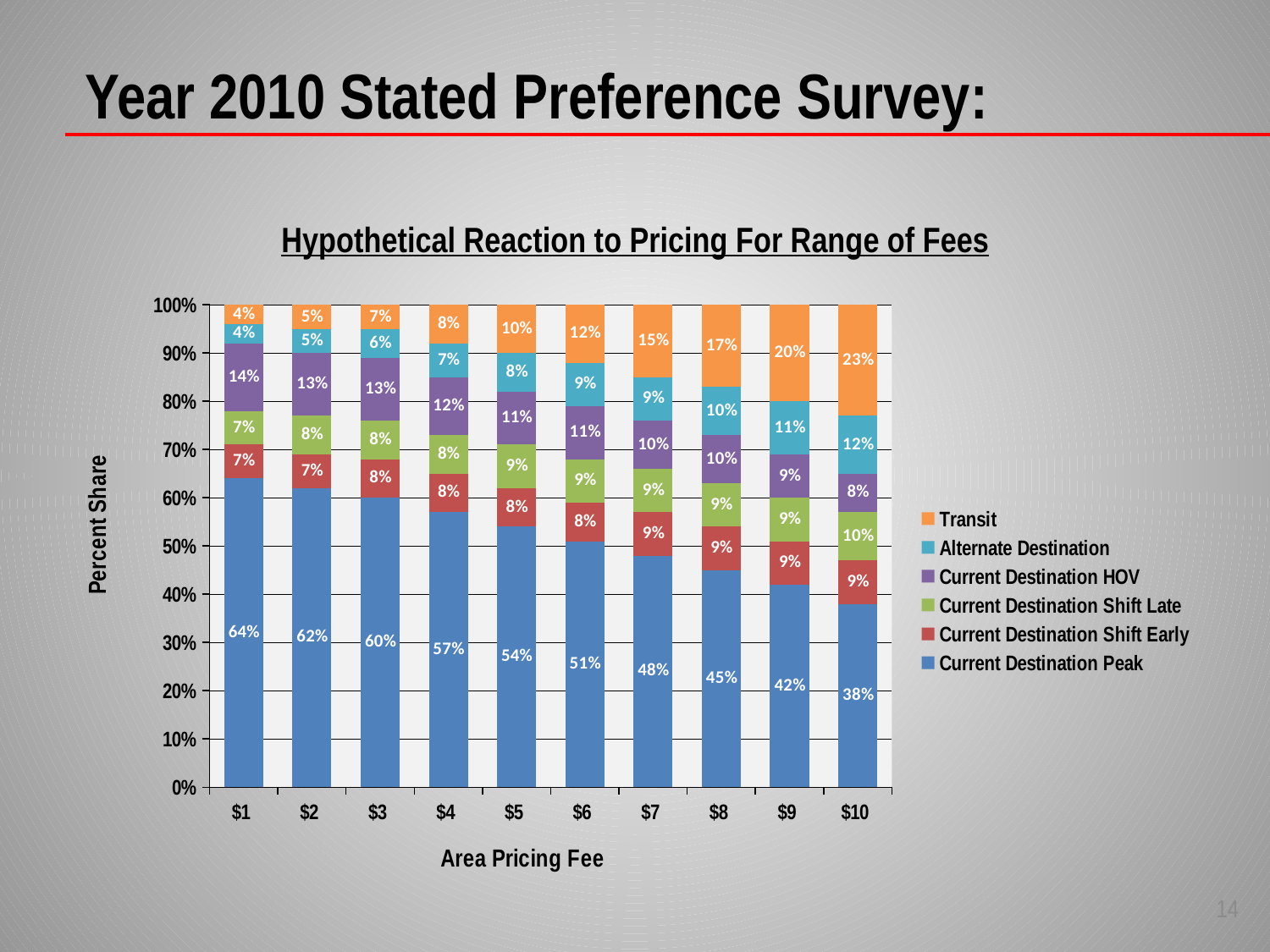
What is the Current Destination HOV share at an Area Pricing Fee of $4? 12% How many Area Pricing Fee categories are shown on the x axis? 10 At which Area Pricing Fee is the Current Destination Peak share lowest? $10 How many series does the legend list? 6 What is the Transit share at an Area Pricing Fee of $10? 23% Which is larger at an Area Pricing Fee of $8: the Transit share or the Current Destination HOV share? Transit What is the Alternate Destination share at an Area Pricing Fee of $7? 9% What kind of chart is shown on the slide? Stacked bar chart What is the difference between the Current Destination Peak share at $1 and at $10? 26% Does the Current Destination Peak share rise or fall as the Area Pricing Fee increases from $1 to $10? Fall At which Area Pricing Fee is the Transit share highest? $10 What is the Current Destination Peak share at an Area Pricing Fee of $1? 64%